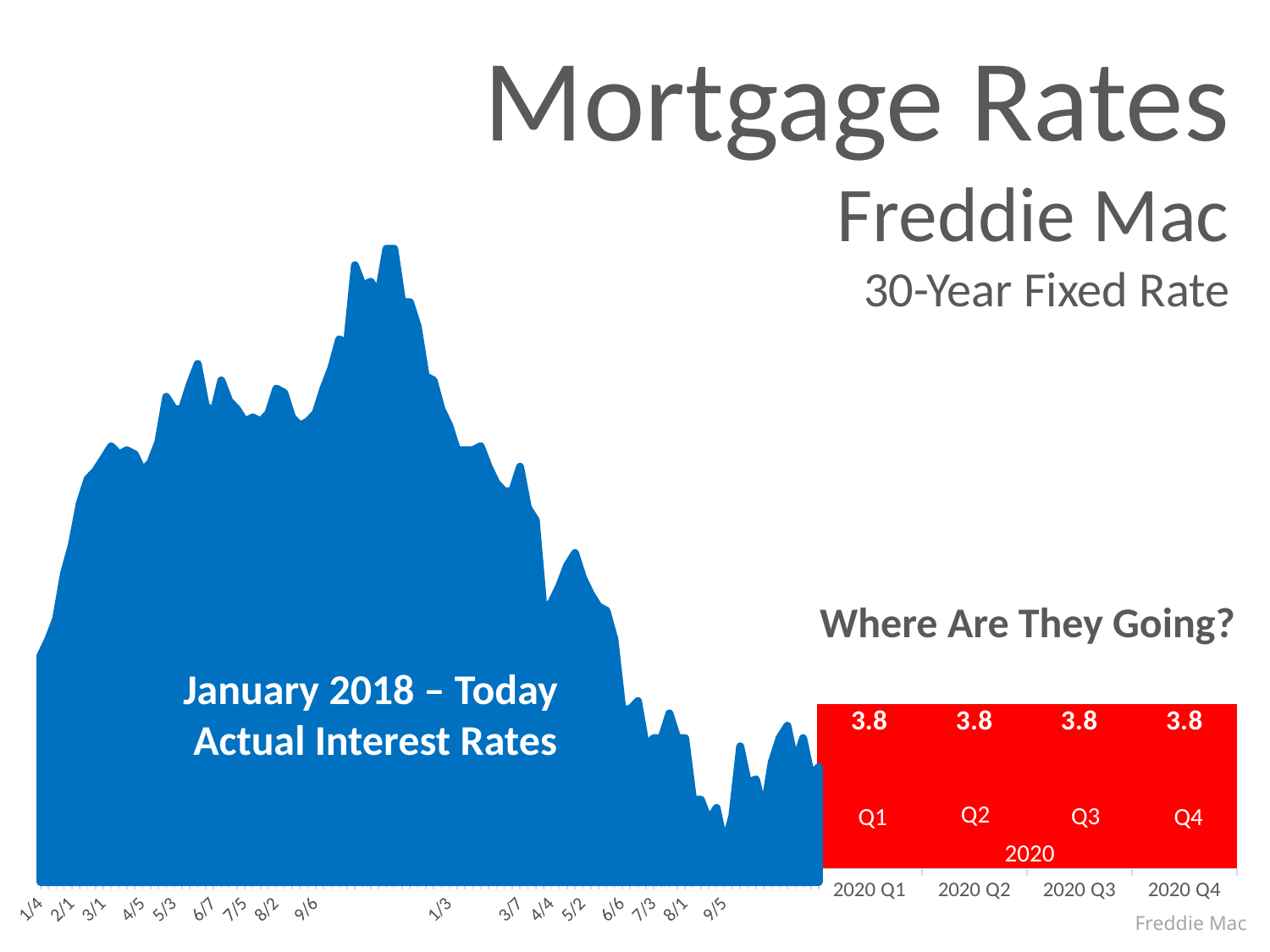
What is the main title of the slide? Mortgage Rates In the red projection chart, what is the projected rate for 2020 Q1? 3.8 What kind of chart is the blue chart labelled 'January 2018 – Today Actual Interest Rates'? area chart How many quarters are shown in the red projection chart? 4 In the red projection chart, what is the projected rate for 2020 Q4? 3.8 In the blue actual interest rates chart, do the values rise or fall between the 1/3 tick and the 9/5 tick at the right end? fall In the red projection chart, what is the projected rate for 2020 Q3? 3.8 In the blue actual interest rates chart, is the value at the right end (9/5) higher or lower than the value at the start (1/4)? lower What source is credited at the bottom right of the slide? Freddie Mac In the red projection chart, what is the difference between the 2020 Q1 and 2020 Q4 projected rates? 0 What kind of chart is the red chart showing the 2020 quarterly projections? bar chart